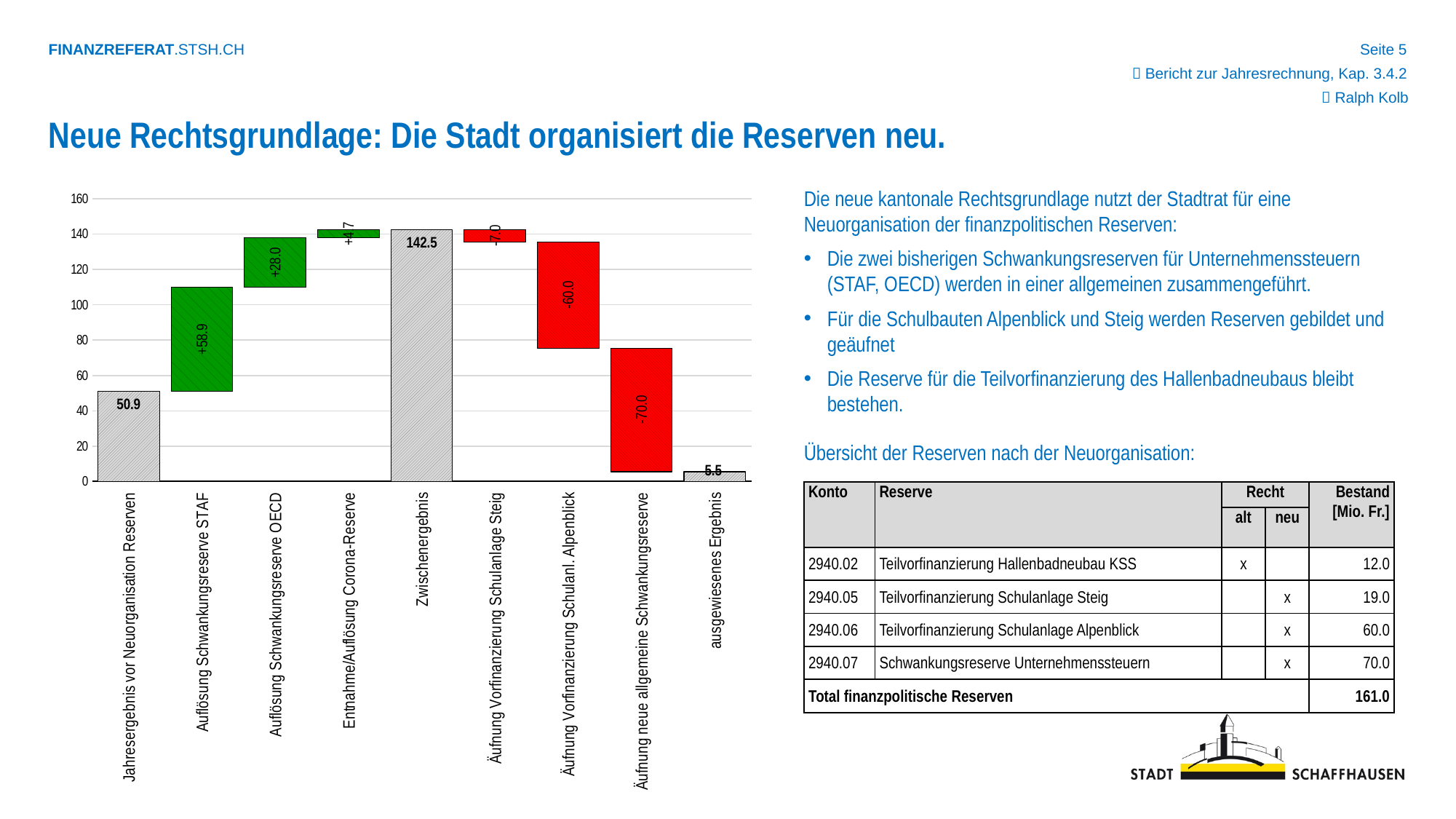
Which category has the highest value in the chart? Zwischenergebnis What is the value for Jahresergebnis vor Neuorganisation Reserven? 50.9 Which category has the lowest value in the chart? Äufnung neue allgemeine Schwankungsreserve How many categories are shown on the x axis of the chart? 9 What is the value for Auflösung Schwankungsreserve OECD? +28.0 What type of chart is shown on the slide? bar chart What is the difference between the Zwischenergebnis and the Jahresergebnis vor Neuorganisation Reserven? 91.6 What is the value for Auflösung Schwankungsreserve STAF? +58.9 Which is larger: the value for Auflösung Schwankungsreserve STAF or Auflösung Schwankungsreserve OECD? Auflösung Schwankungsreserve STAF What is the value for Äufnung Vorfinanzierung Schulanl. Alpenblick? -60.0 What is the value for ausgewiesenes Ergebnis? 5.5 What is the value for Zwischenergebnis? 142.5